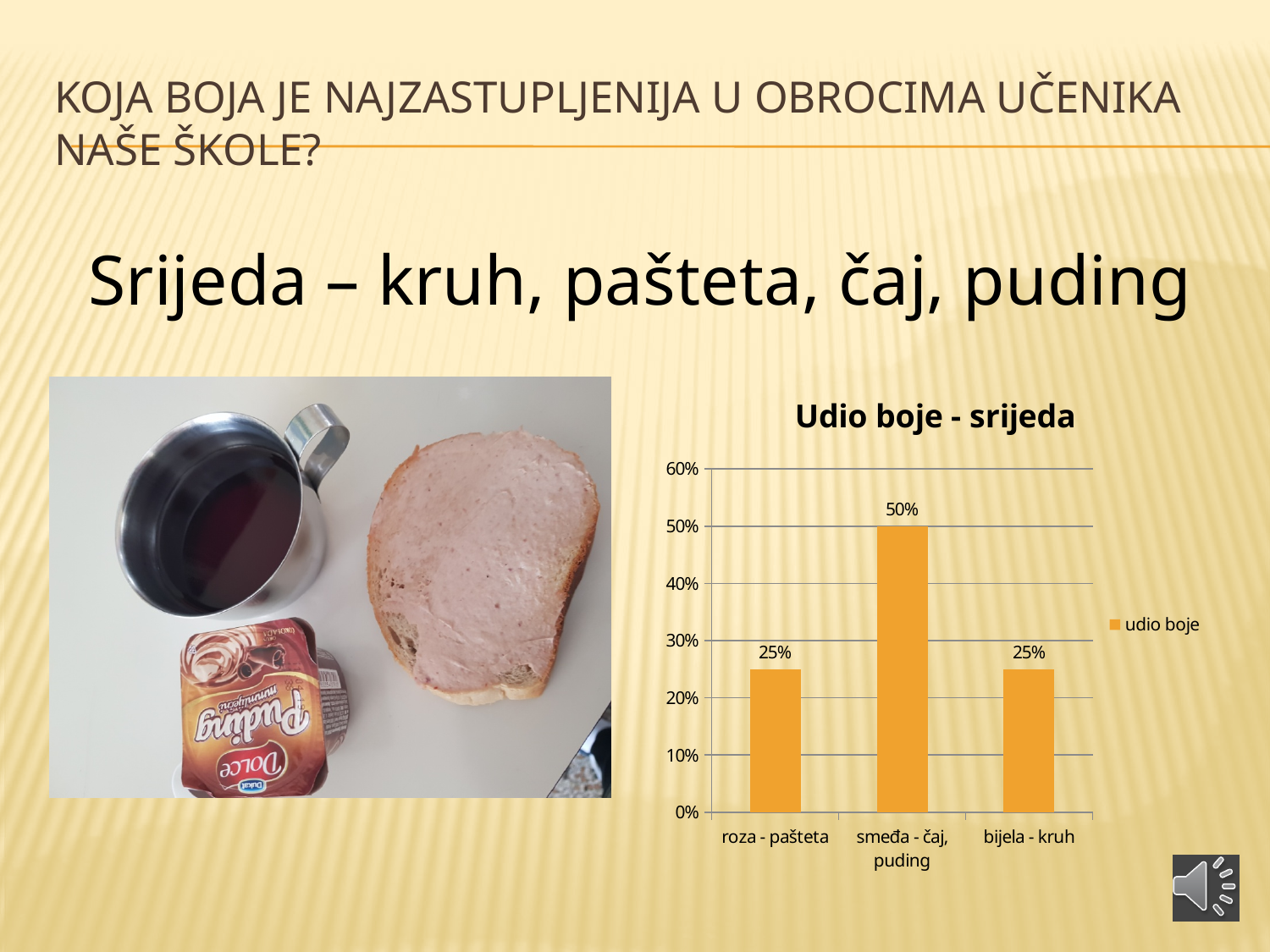
Is the value for 'smeđa - čaj, puding' greater or less than 40%? greater What kind of chart is shown? bar chart What is the value for 'roza - pašteta'? 25% What is the title of the chart? Udio boje - srijeda How many categories are shown on the x axis? 3 How many series does the legend list? 1 Which is larger, the value for 'smeđa - čaj, puding' or the value for 'bijela - kruh'? smeđa - čaj, puding What is the value for 'bijela - kruh'? 25% Which category has the highest value? smeđa - čaj, puding What is the difference between the values for 'smeđa - čaj, puding' and 'roza - pašteta'? 25% Is the value for 'roza - pašteta' greater or less than 30%? less What is the value for 'smeđa - čaj, puding'? 50%